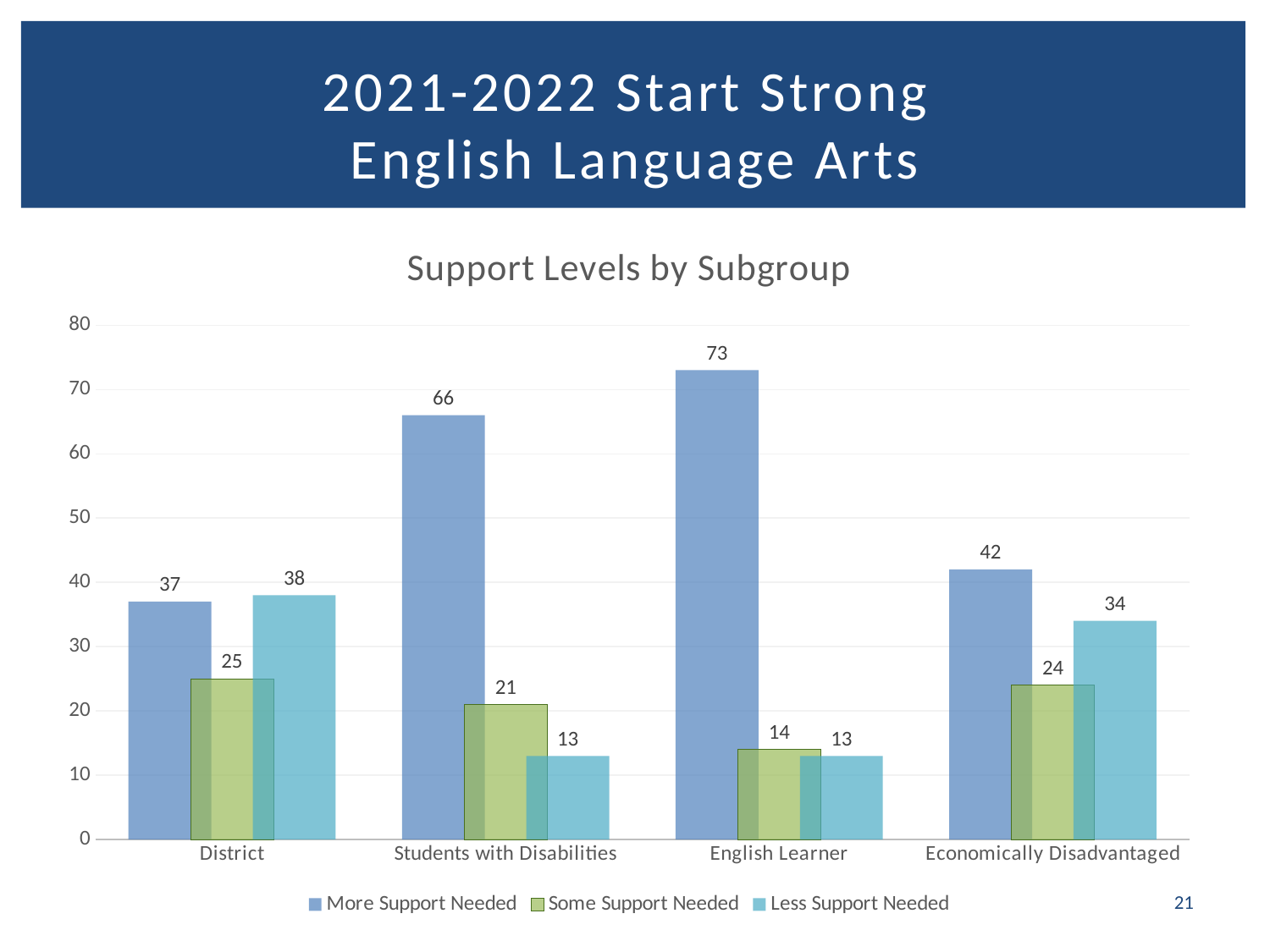
Which is larger for the District category: More Support Needed or Less Support Needed? Less Support Needed Which subgroup has the lowest value for Some Support Needed? English Learner How many subgroups are shown on the x axis? 4 How many series does the legend list? 3 Is the value for More Support Needed for Students with Disabilities greater or less than 60? greater What kind of chart is shown on the slide? Bar chart What is the value for More Support Needed in the English Learner subgroup? 73 What is the difference between More Support Needed and Less Support Needed for Economically Disadvantaged? 8 What is the title of the chart? Support Levels by Subgroup Which subgroup has the highest value for More Support Needed? English Learner What is the value for Less Support Needed in the District category? 38 What is the value for Some Support Needed for Students with Disabilities? 21